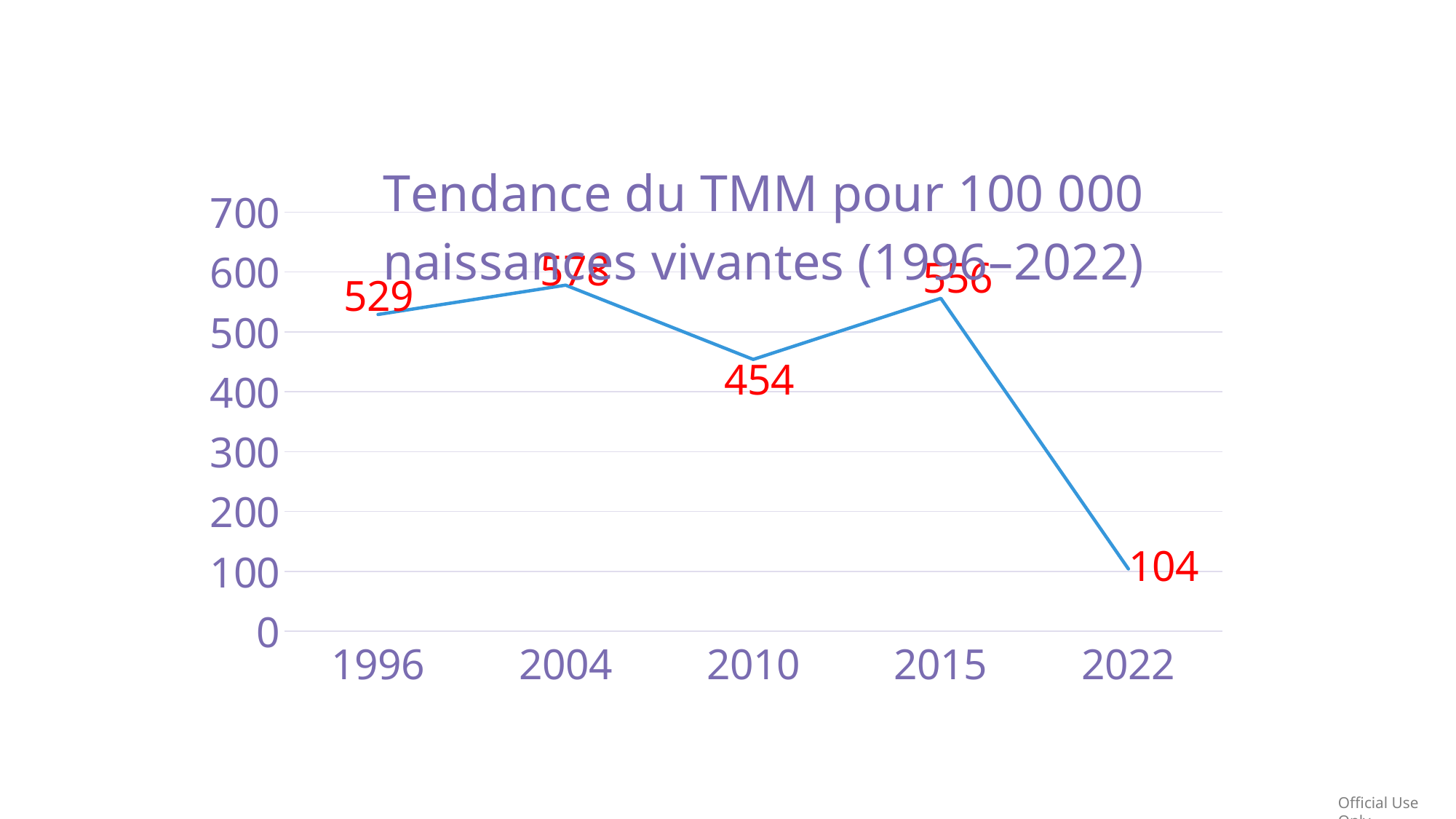
How many years are plotted on the x axis? 5 Is the value for 2022 greater or less than 200? less What is the value for 1996? 529 Which year has the highest value? 2004 Which year has the lowest value? 2022 What is the difference between the values for 1996 and 2010? 75 Which is larger, the value for 1996 or the value for 2010? 1996 What is the difference between the values for 1996 and 2022? 425 What is the value for 2022? 104 What is the value for 2004? 578 What is the value for 2010? 454 What kind of chart is shown? line chart